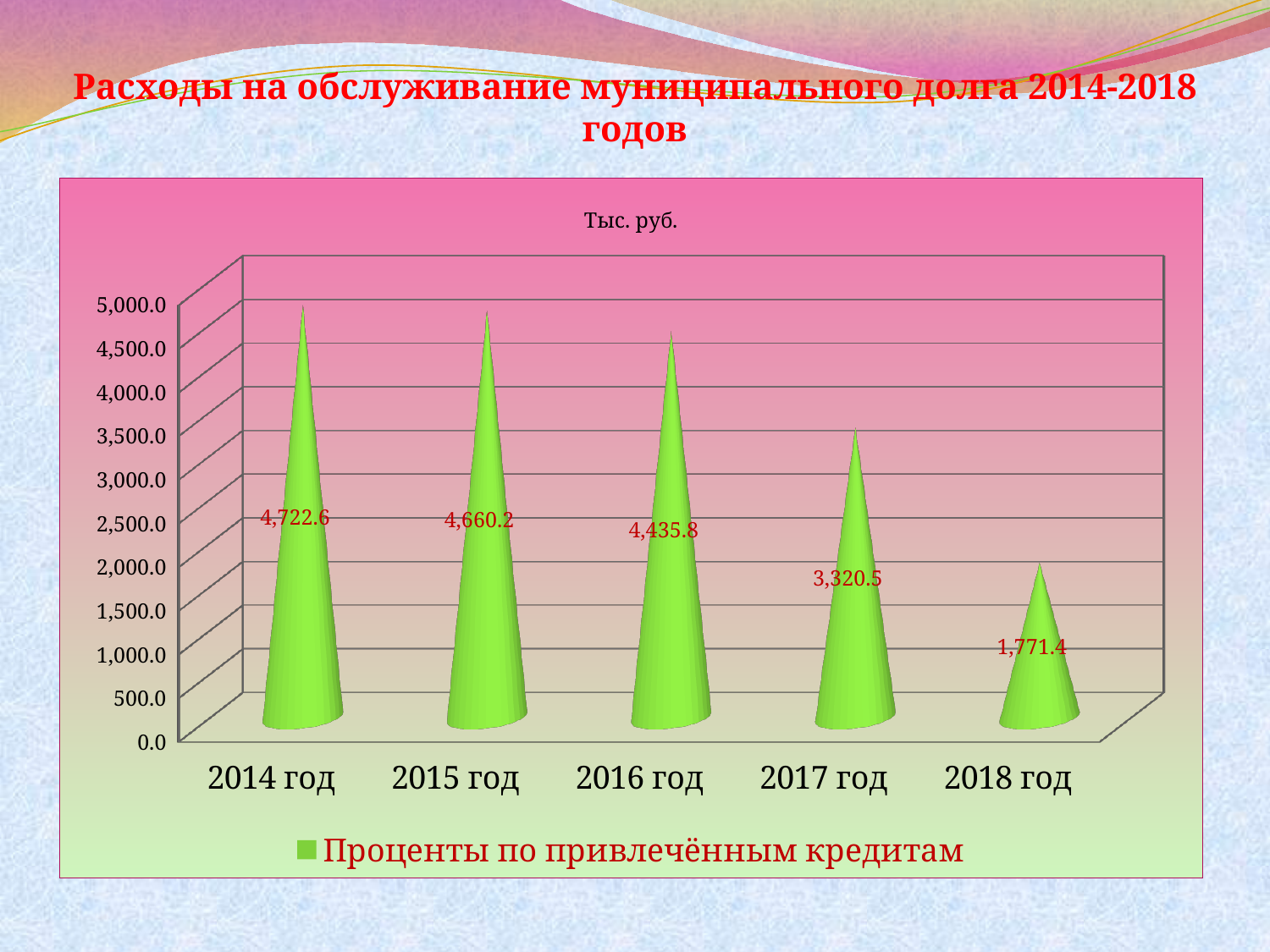
Do the values rise or fall from 2014 год to 2018 год? fall What is the value for 2018 год? 1,771.4 Which is larger, the value for 2015 год or the value for 2016 год? 2015 год Which year has the lowest value? 2018 год Which year has the highest value? 2014 год What is the value for 2014 год? 4,722.6 What is the difference between the values for 2014 год and 2018 год? 2,951.2 Is the value for 2017 год greater or less than 3,000.0? greater How many years are shown on the x axis? 5 What is the value for 2017 год? 3,320.5 What is the difference between the values for 2016 год and 2017 год? 1,115.3 What is the legend entry for the series shown? Проценты по привлечённым кредитам